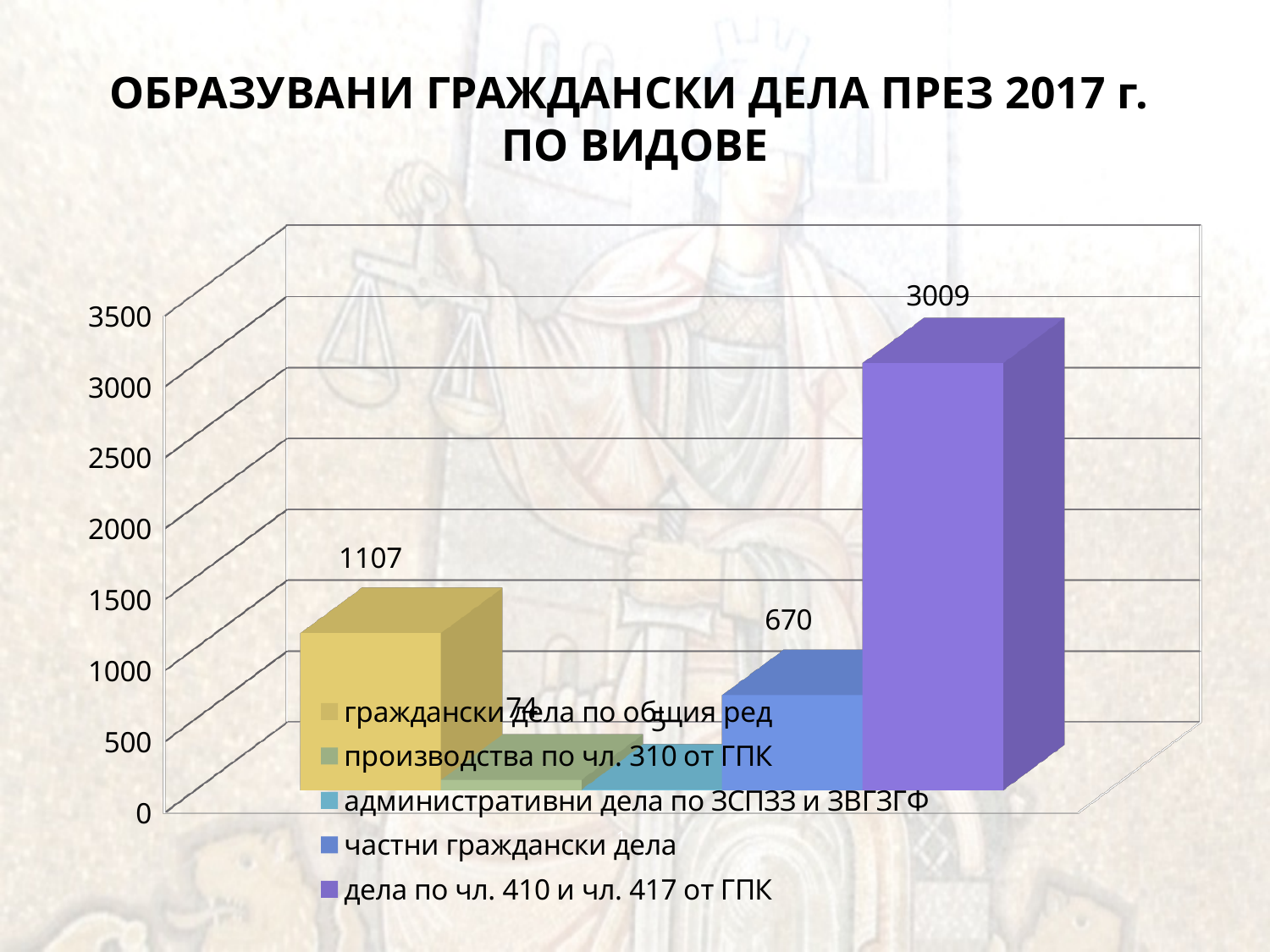
What is the difference between граждански дела по общия ред and частни граждански дела? 437 Is the value for частни граждански дела greater or less than 1000? less Which is larger: граждански дела по общия ред or частни граждански дела? граждански дела по общия ред Which category has the highest value? дела по чл. 410 и чл. 417 от ГПК What kind of chart is shown on the slide? bar chart What is the value for дела по чл. 410 и чл. 417 от ГПК? 3009 What is the value for производства по чл. 310 от ГПК? 74 How many series does the legend list? 5 What is the value for граждански дела по общия ред? 1107 Is the value for дела по чл. 410 и чл. 417 от ГПК greater or less than 2500? greater What is the value for частни граждански дела? 670 What is the difference between дела по чл. 410 и чл. 417 от ГПК and граждански дела по общия ред? 1902